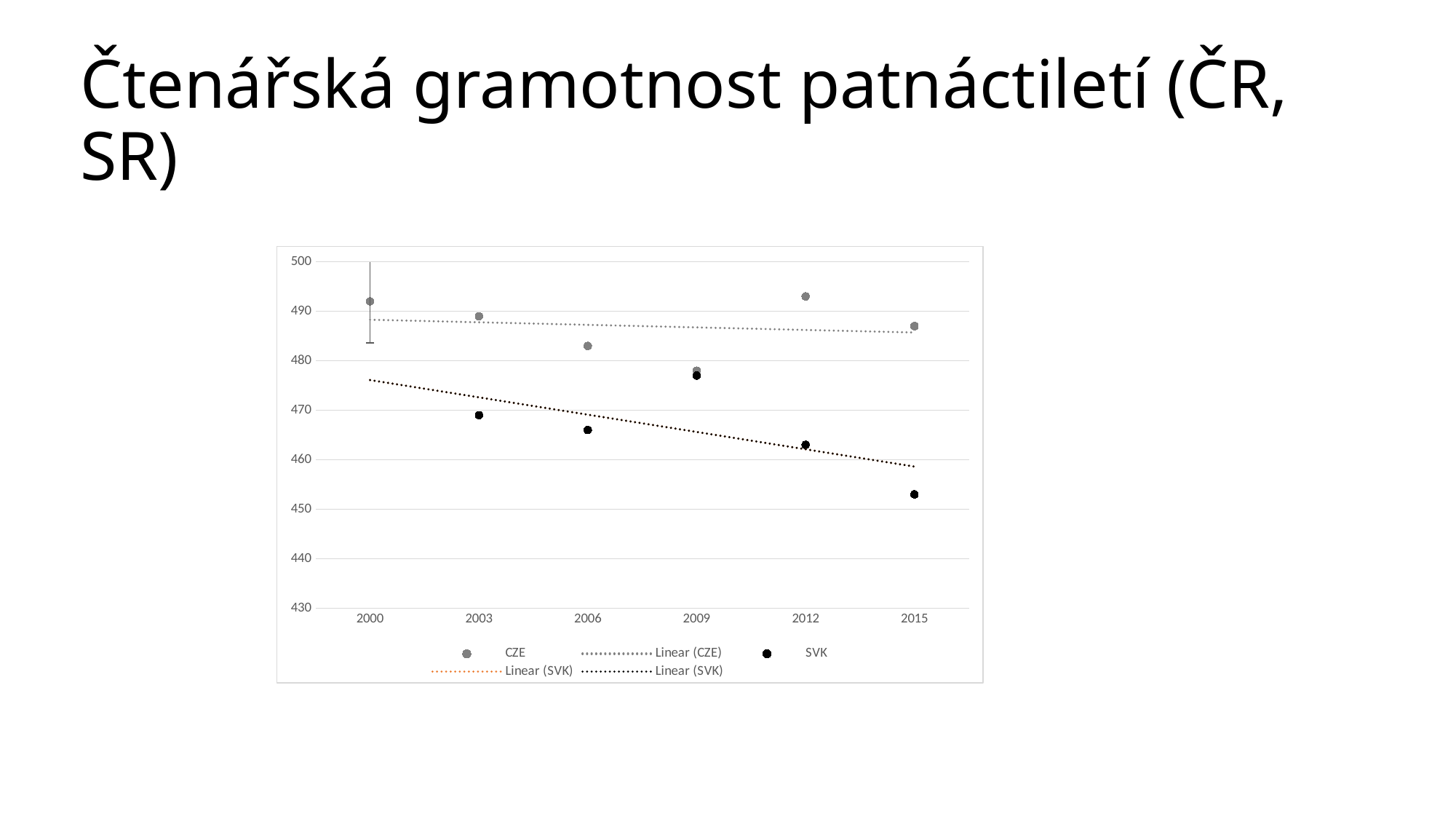
Is the SVK value for 2009 greater or less than 470? greater How many years are shown on the x axis of the chart? 6 In which year is the CZE value lowest? 2009 Is the CZE value for 2012 greater or less than 490? greater In which year is the SVK value highest? 2009 Which series has the larger value in 2015, CZE or SVK? CZE What kind of chart is shown on the slide? scatter chart How many entries does the chart legend list? 5 Is the CZE value for 2006 greater or less than 490? less In which year is the SVK value lowest? 2015 Does the Linear (SVK) trendline rise or fall from 2000 to 2015? fall